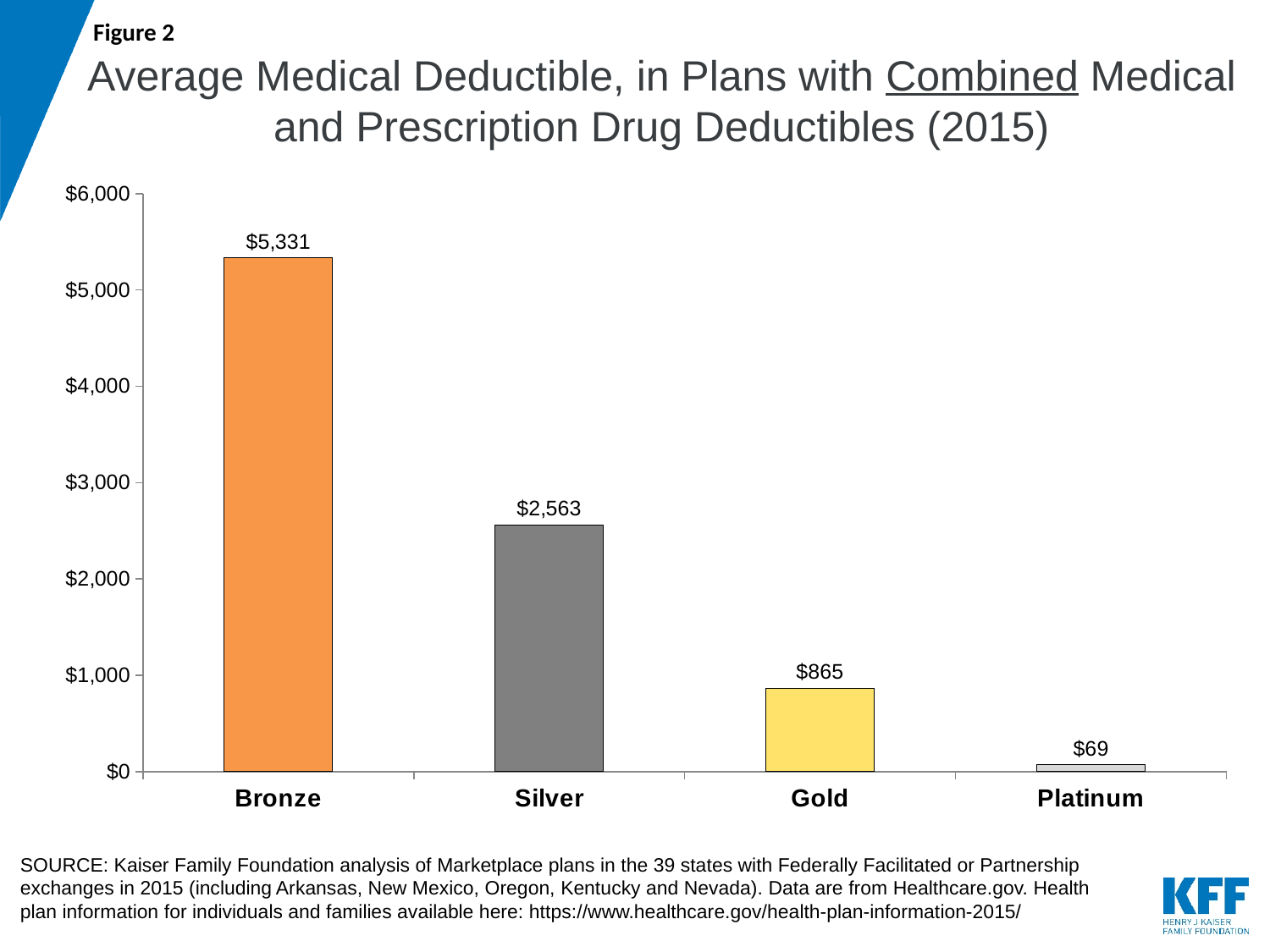
What is the difference between the Gold and Platinum average medical deductibles? $796 What is the difference between the Bronze and Silver average medical deductibles? $2,768 What is the average medical deductible for Silver plans? $2,563 What is the average medical deductible for Gold plans? $865 What is the average medical deductible for Platinum plans? $69 Which plan type has the lowest average medical deductible? Platinum Which plan type has the highest average medical deductible? Bronze How many plan types are shown in the chart? 4 Which has a larger average medical deductible, Silver or Gold? Silver What is the average medical deductible for Bronze plans? $5,331 What kind of chart is shown on the slide? Bar chart Do the values rise or fall moving from Bronze to Platinum along the x axis? Fall